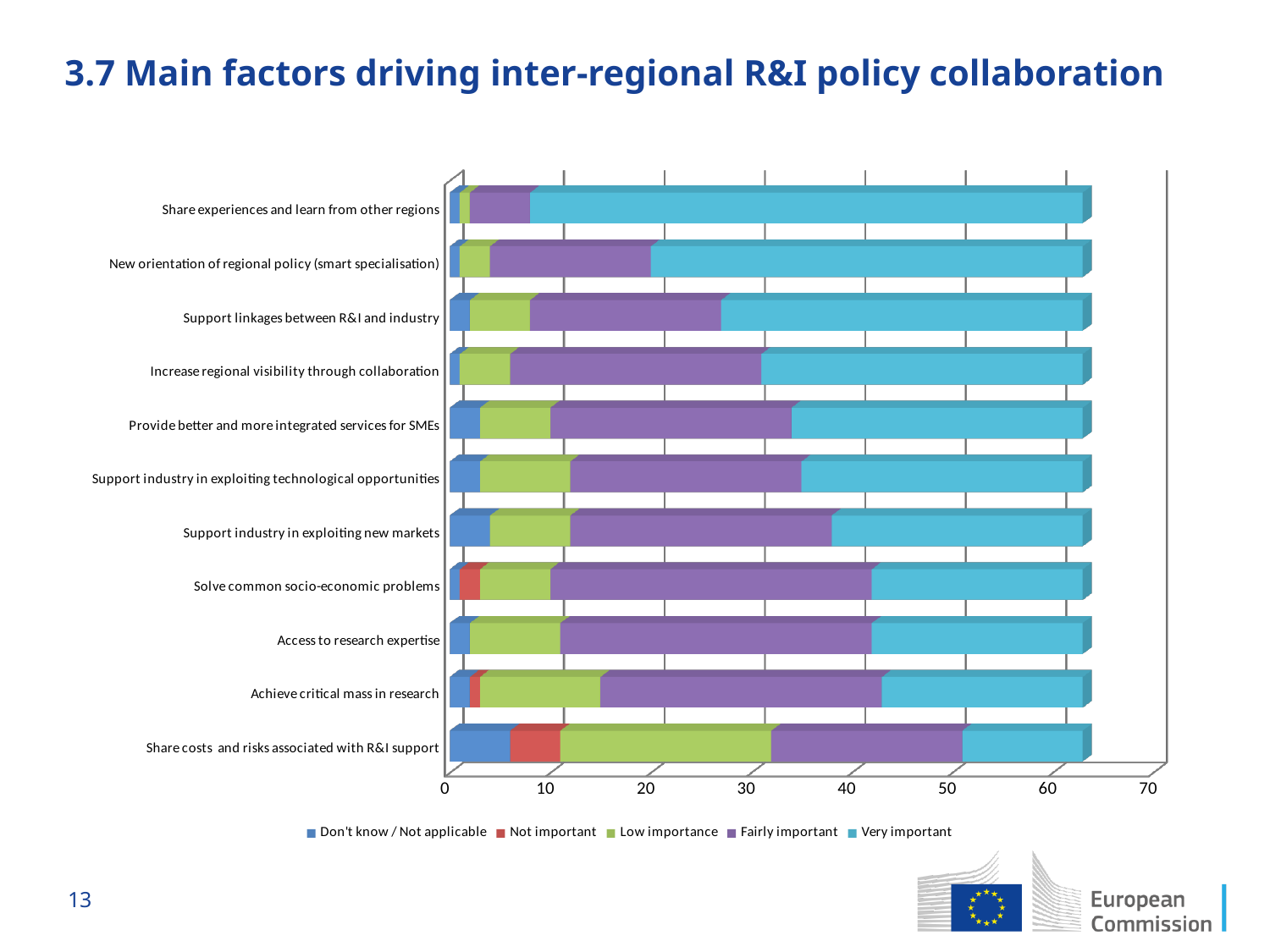
Which legend entry is shown in red? Not important Which factor has the smallest 'Fairly important' segment? Share experiences and learn from other regions Which factor has the largest 'Very important' segment? Share experiences and learn from other regions How many series does the chart's legend list? 5 What is the title of the slide containing the chart? 3.7 Main factors driving inter-regional R&I policy collaboration Which has the larger 'Not important' segment: 'Share costs and risks associated with R&I support' or 'Solve common socio-economic problems'? Share costs and risks associated with R&I support Which has the larger 'Very important' segment: 'Access to research expertise' or 'Support linkages between R&I and industry'? Support linkages between R&I and industry What kind of chart is shown on the slide? Stacked bar chart Is the total length of the bar for 'Share experiences and learn from other regions' greater or less than 60? greater Which factor has the smallest 'Very important' segment? Share costs and risks associated with R&I support How many factors (categories) are listed on the vertical axis of the chart? 11 Which factor has the largest 'Low importance' segment? Share costs and risks associated with R&I support